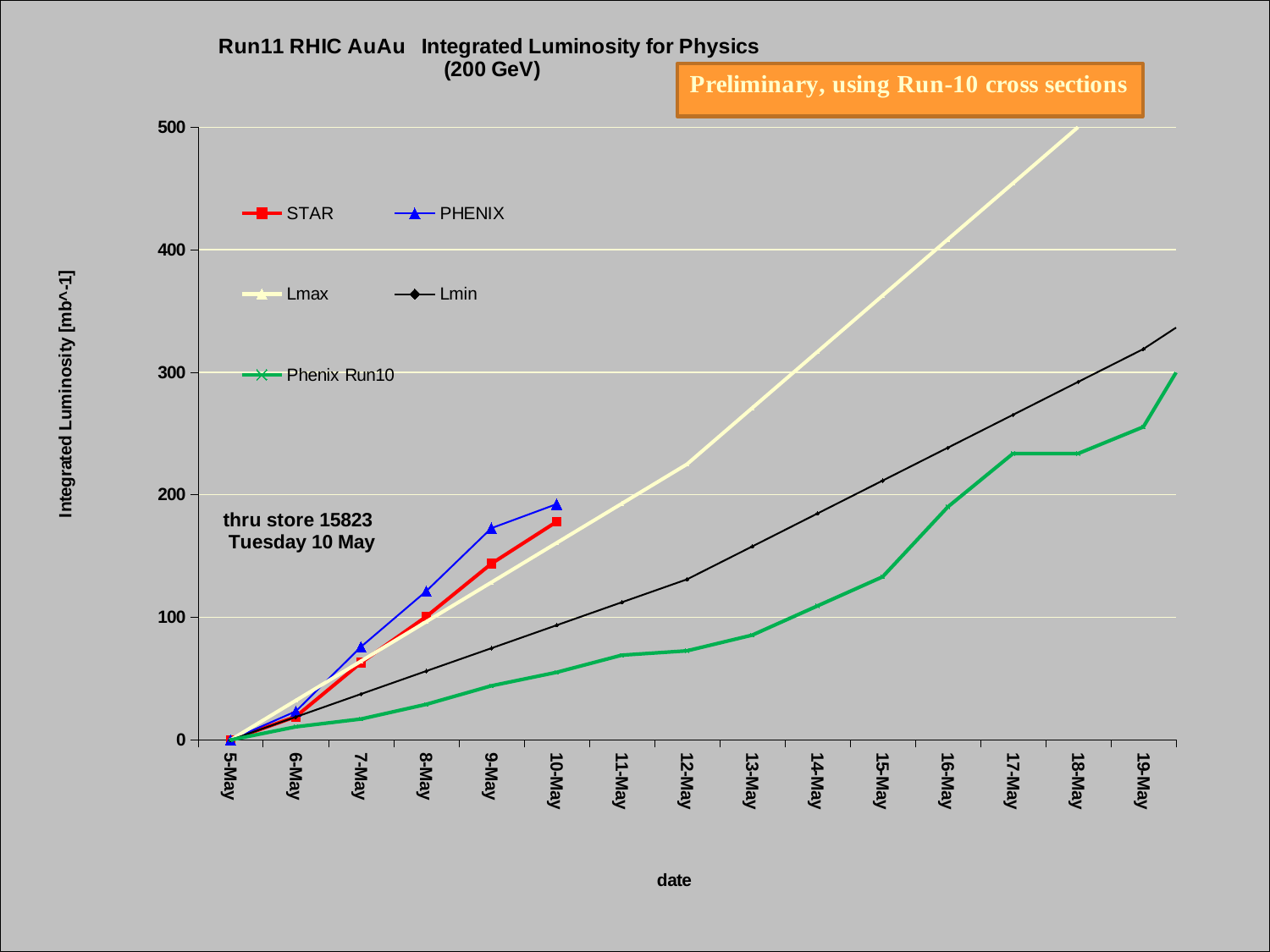
What kind of chart is shown on the slide? line chart Is the value for PHENIX on 10-May greater or less than 200? less On 9-May, which series has the higher value, STAR or PHENIX? PHENIX On 15-May, which series has the higher value, Lmin or Phenix Run10? Lmin Is the value for Lmax on 16-May greater or less than 400? greater How many series does the legend list? 5 What is the label on the y axis? Integrated Luminosity [mb^-1] Through which store number does the annotation say the data runs? 15823 How many dates are shown along the x axis? 15 Do the values for Lmin rise or fall from 5-May to 19-May? rise Is the value for Phenix Run10 on 12-May greater or less than 100? less